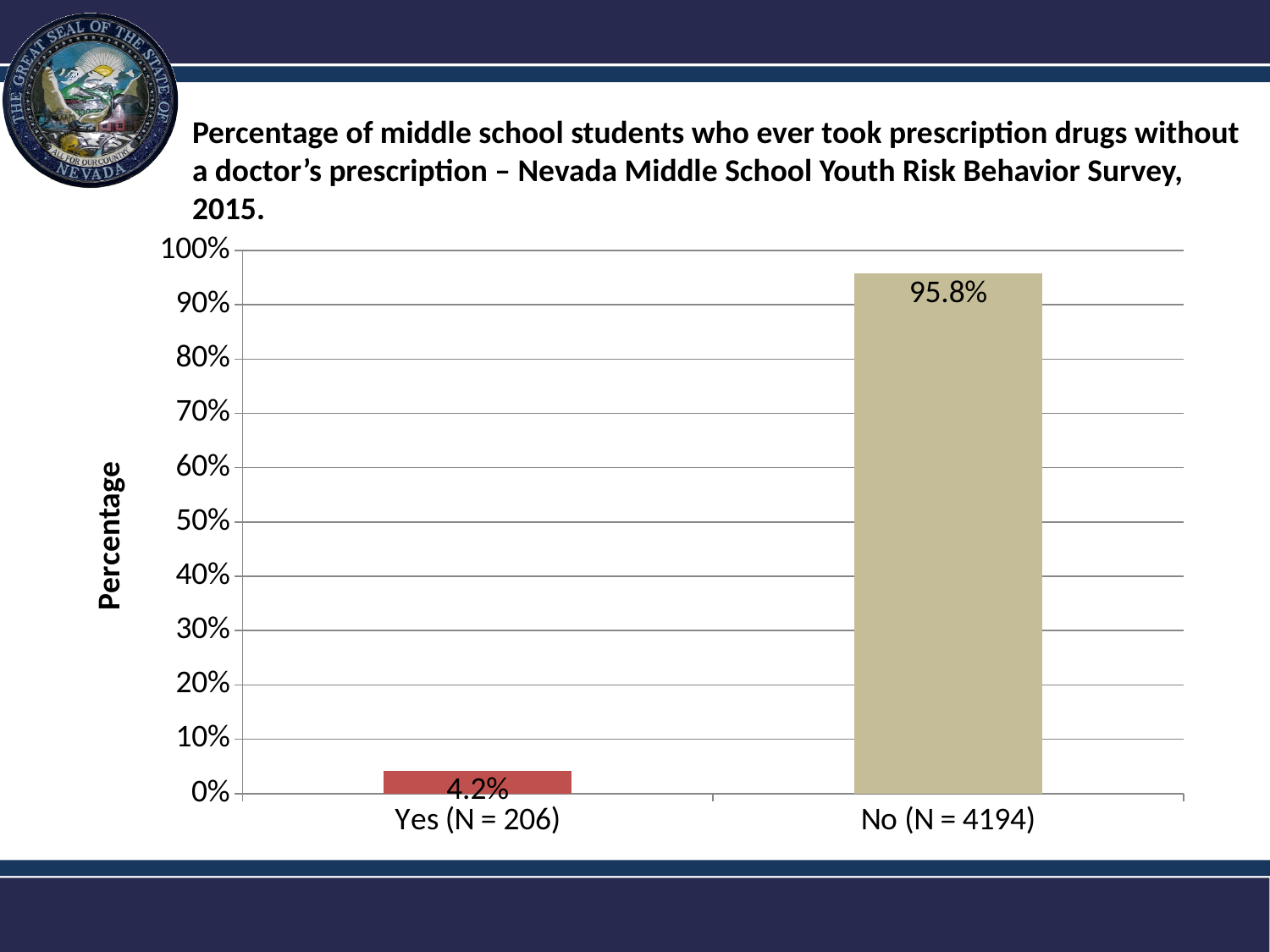
What is the label of the y axis? Percentage Which category has the lowest percentage? Yes (N = 206) Which is larger, the percentage for "Yes" or the percentage for "No"? No What percentage of middle school students answered "Yes" to ever taking prescription drugs without a doctor's prescription? 4.2% Is the value for "No (N = 4194)" greater or less than 90%? greater How many categories are shown on the x axis? 2 Is the value for "Yes (N = 206)" greater or less than 10%? less What is the difference in percentage points between the "No" and "Yes" categories? 91.6% Which category has the highest percentage? No (N = 4194) What kind of chart is shown on the slide? Bar chart What is the sample size (N) for the "Yes" category? 206 What percentage of middle school students answered "No" to ever taking prescription drugs without a doctor's prescription? 95.8%